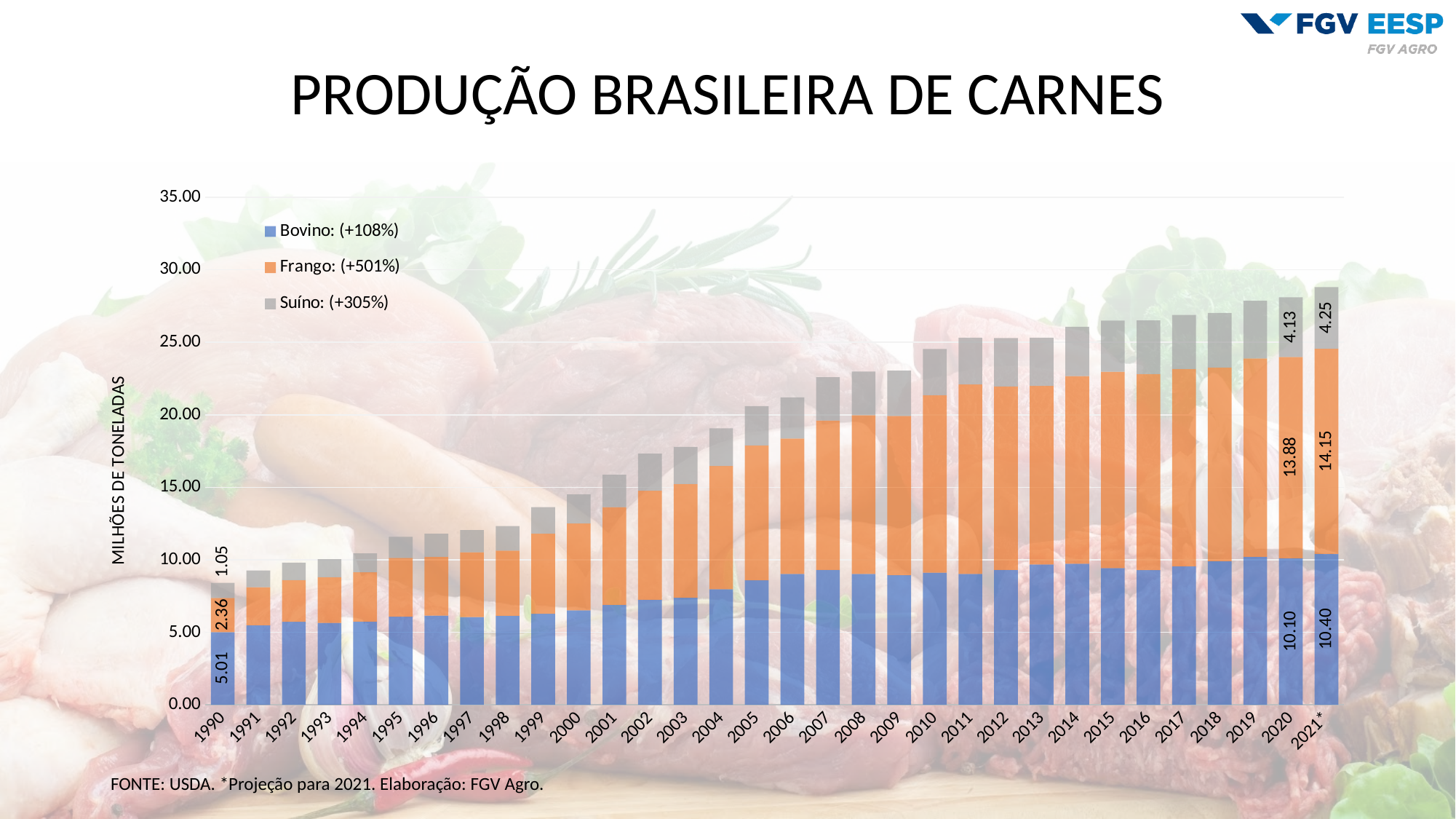
Do the total bar heights generally rise or fall from 1990 to 2021*? Rise What is the total of the stacked bar for 2021*? 28.80 Is the total for 2010 greater or less than 20.00? greater What type of chart is shown on the slide? Stacked bar chart Which is larger in 2020, the Bovino value or the Frango value? Frango What percentage growth does the legend show for Frango? +501% What is the total of the stacked bar for 1990? 8.42 How many series does the legend list? 3 What is the Bovino value for 1990? 5.01 What is the Frango value for 2021*? 14.15 What is the difference between the Frango values for 2021* and 2020? 0.27 What is the Suíno value for 2020? 4.13